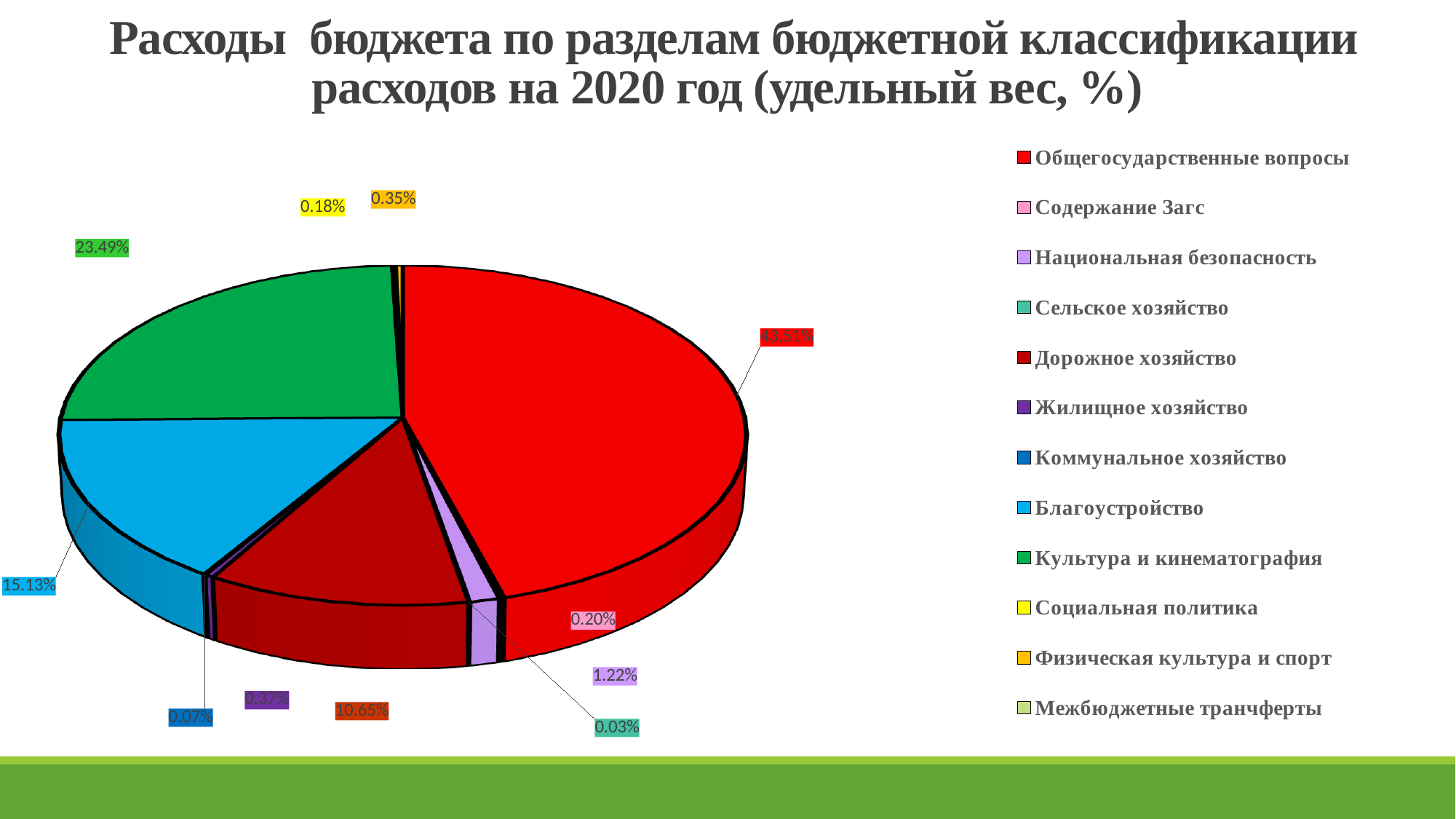
What share is labelled for Культура и кинематография? 23.49% What share is labelled for Благоустройство? 15.13% What kind of chart is shown on the slide? pie chart What is the difference between the shares for Общегосударственные вопросы and Культура и кинематография? 20.02% What share is labelled for Национальная безопасность? 1.22% Which is larger, the share for Благоустройство or the share for Дорожное хозяйство? Благоустройство Which category has the largest share of the pie? Общегосударственные вопросы What is the title of the chart? Расходы бюджета по разделам бюджетной классификации расходов на 2020 год (удельный вес, %) How many entries does the legend list? 12 Which category has the smallest labelled share? Сельское хозяйство What share is labelled for Дорожное хозяйство? 10.65% What share of budget expenditure is labelled for Общегосударственные вопросы? 43.51%